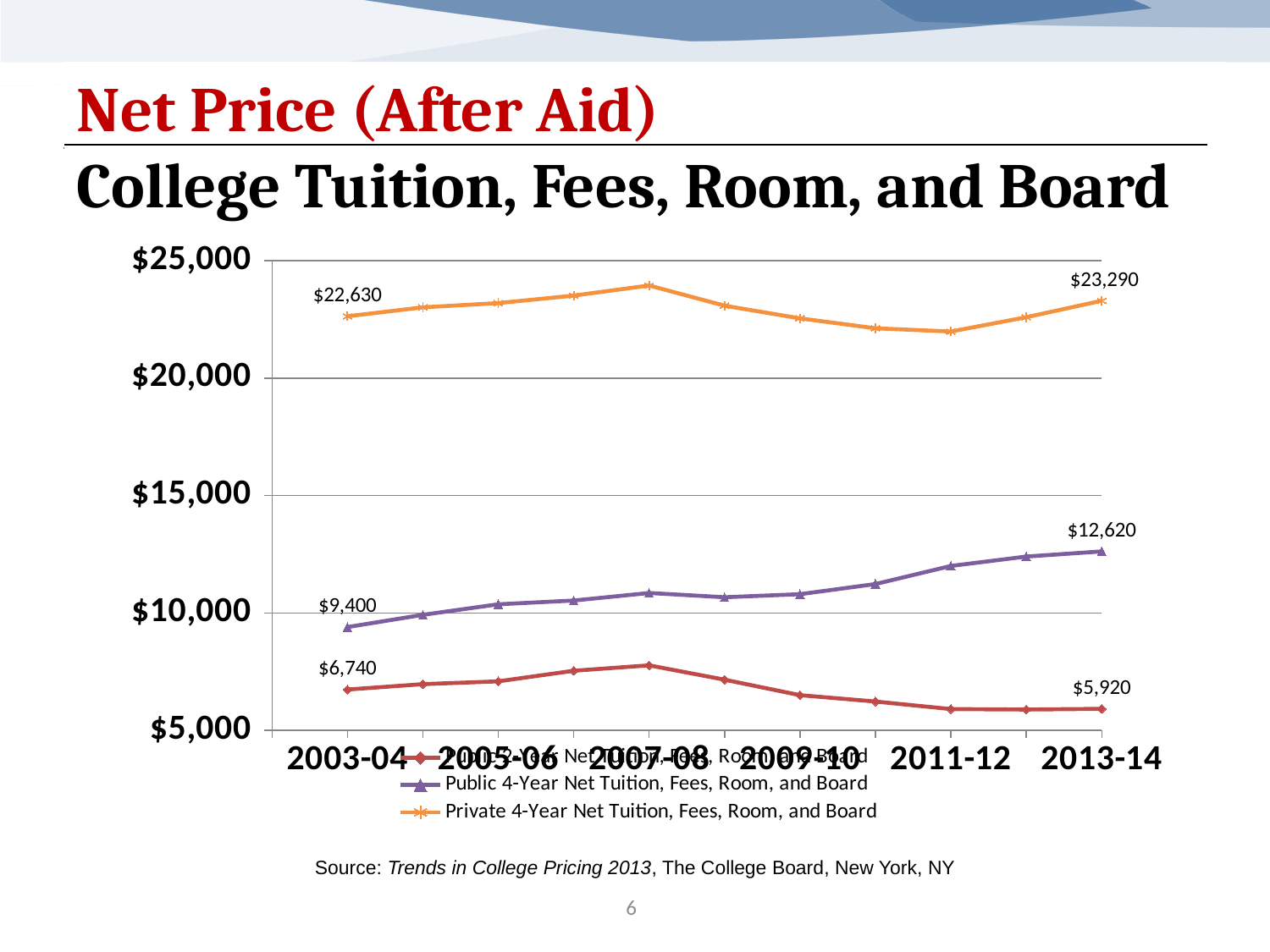
Does the Public 4-Year net price rise or fall from 2003-04 to 2013-14? Rise What is the Private 4-Year net tuition, fees, room, and board value for 2003-04? $22,630 Is the Public 4-Year value for 2007-08 greater or less than $10,000? greater What is the Private 4-Year net tuition, fees, room, and board value for 2013-14? $23,290 What is the value of the red (Public 2-Year) line in 2003-04? $6,740 What is the Public 4-Year net tuition, fees, room, and board value for 2003-04? $9,400 What is the Public 4-Year net tuition, fees, room, and board value for 2013-14? $12,620 What kind of chart is shown on the slide? Line chart How many series does the legend list? 3 By how much did the Private 4-Year net price increase from 2003-04 to 2013-14? $660 What is the value of the red (Public 2-Year) line in 2013-14? $5,920 By how much did the Public 4-Year net price increase from 2003-04 to 2013-14? $3,220